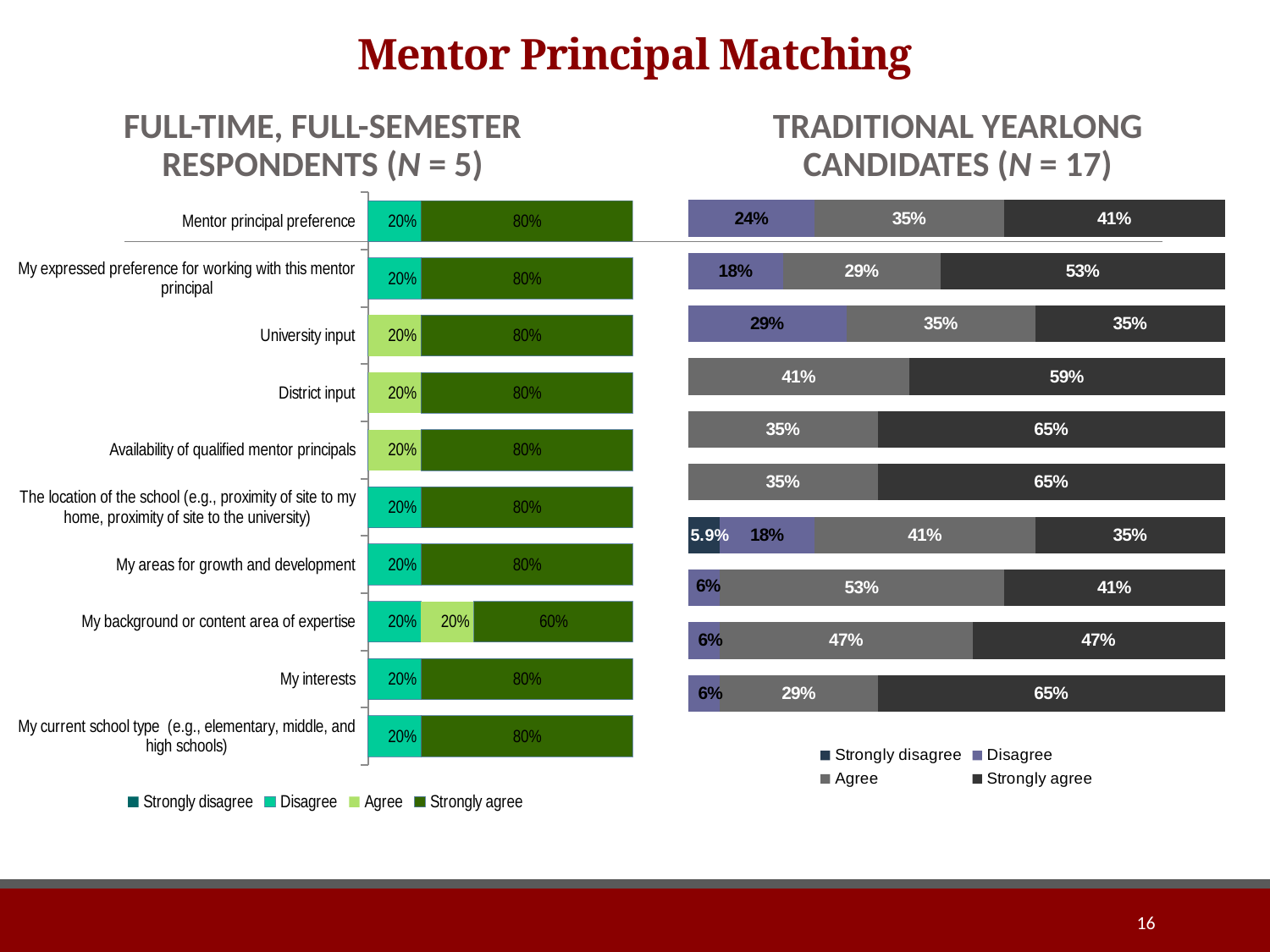
In the Traditional yearlong candidates chart, what is the Strongly agree value for "My expressed preference for working with this mentor principal"? 53% How many categories are shown in the Full-time, full-semester respondents chart? 10 How many series does the legend of the Traditional yearlong candidates chart list? 4 In the Full-time, full-semester respondents chart, what is the Strongly agree value for "My background or content area of expertise"? 60% In the Traditional yearlong candidates chart, which has the larger Strongly agree value: "My interests" or "My current school type"? My current school type In the Traditional yearlong candidates chart, what is the Strongly disagree value for "My areas for growth and development"? 5.9% In the Full-time, full-semester respondents chart, which category has the lowest Strongly agree value? My background or content area of expertise In the Traditional yearlong candidates chart, what is the Strongly agree value for "District input"? 59% In the Traditional yearlong candidates chart, what is the difference between the Strongly agree and Agree values for "District input"? 18 percentage points What kind of chart is the Full-time, full-semester respondents chart? Stacked bar chart In the Traditional yearlong candidates chart, what is the Agree value for "Mentor principal preference"? 35% In the Traditional yearlong candidates chart, what is the Agree value for "My background or content area of expertise"? 53%